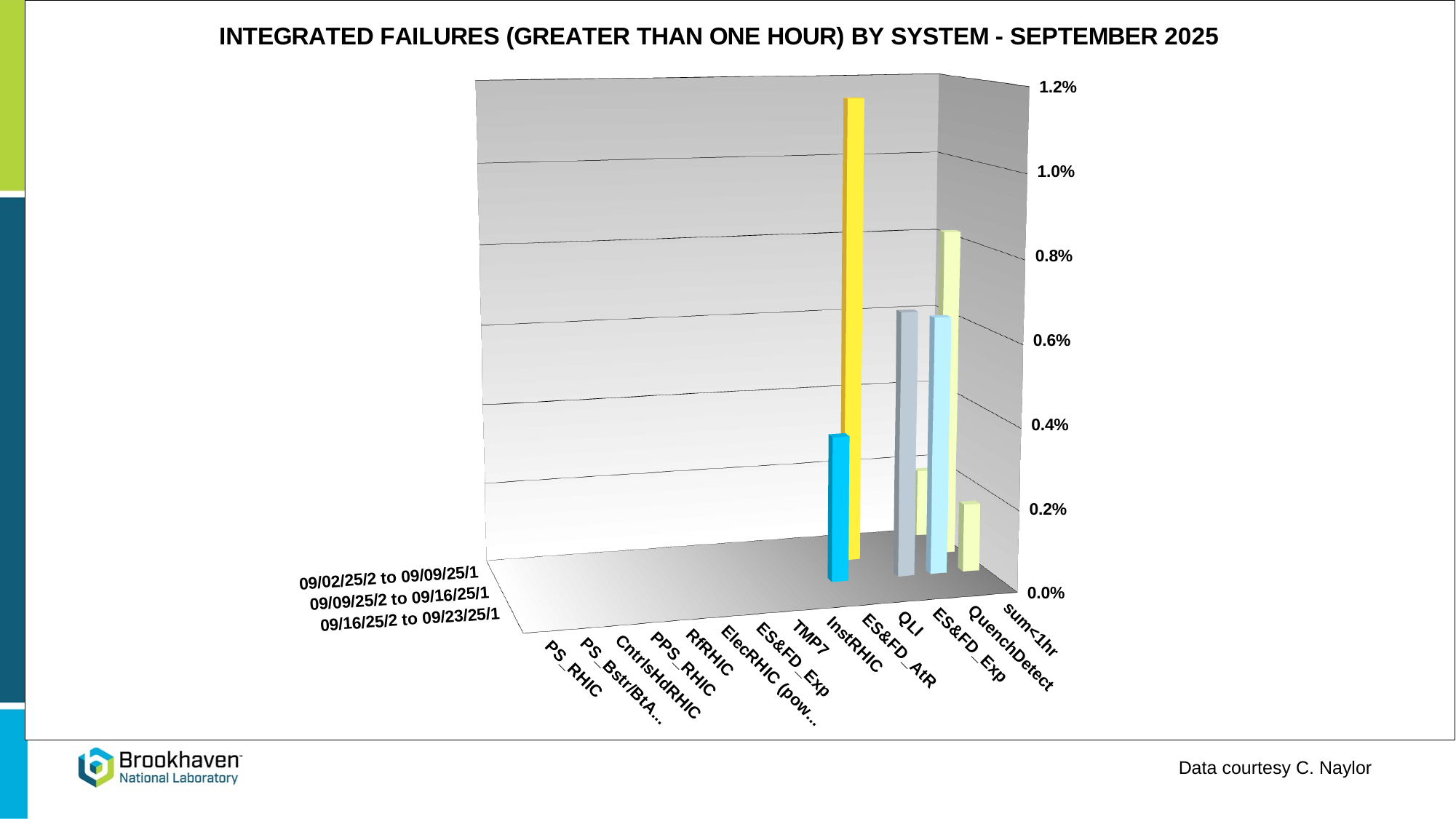
How many date-range series are plotted on the depth axis of the chart? 3 How many system categories are listed along the x axis of the chart? 14 What is the title of the chart? INTEGRATED FAILURES (GREATER THAN ONE HOUR) BY SYSTEM - SEPTEMBER 2025 Is the value of the tallest bar in the chart greater or less than 0.8%? greater Which category is listed last on the x axis of the chart? sum<1hr What kind of chart is shown on the slide? bar chart Which date-range series is listed first (at the back) on the depth axis? 09/02/25/2 to 09/09/25/1 Is the value of the tallest bar in the chart greater or less than 1.0%? greater What is the highest tick value shown on the vertical axis of the chart? 1.2%